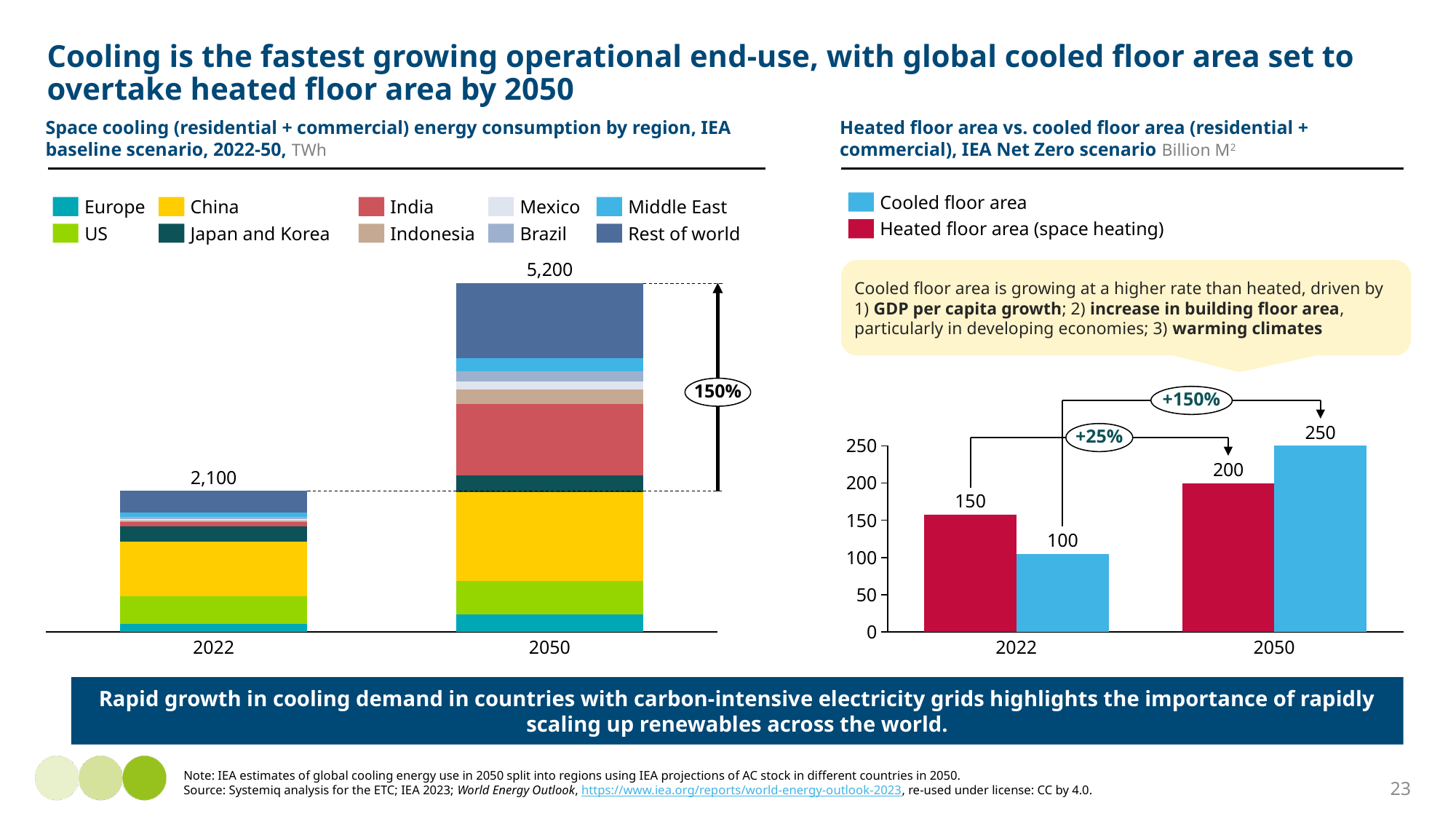
In the right chart (heated vs. cooled floor area), which bar is the lowest? Cooled floor area in 2022 In the right chart (heated vs. cooled floor area), what is the cooled floor area in 2050? 250 In the left chart (space cooling energy consumption by region), how many regions does the legend list? 10 In the left chart (space cooling energy consumption by region), what is the total for 2050? 5,200 In the right chart (heated vs. cooled floor area), what is the difference between cooled floor area and heated floor area in 2050? 50 In the right chart (heated vs. cooled floor area), what unit is given in the chart subtitle? Billion M² In the right chart (heated vs. cooled floor area), what is the heated floor area in 2022? 150 In the left chart (space cooling energy consumption by region), what is the difference between the 2050 total and the 2022 total? 3,100 In the left chart (space cooling energy consumption by region), what is the total for 2022? 2,100 In the right chart (heated vs. cooled floor area), which is larger in 2022: heated floor area or cooled floor area? Heated floor area In the left chart (space cooling energy consumption by region), what percentage growth is annotated between 2022 and 2050? 150% What kind of chart is the left chart (space cooling energy consumption by region)? Stacked bar chart